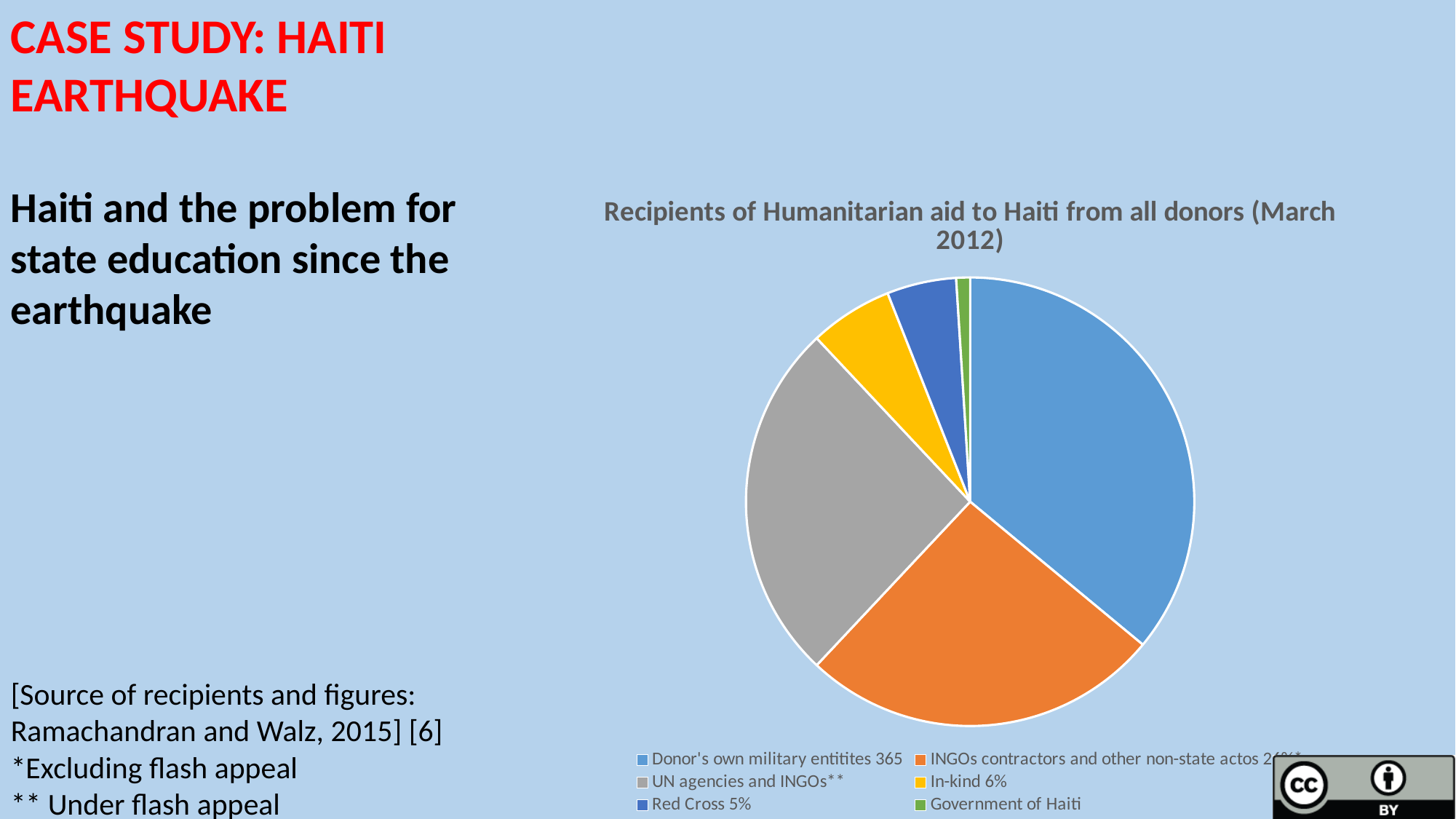
How many slices does the pie chart have? 6 What share of humanitarian aid went to the Red Cross, according to the legend? 5% Which recipient category has the smallest slice of the pie? Government of Haiti What kind of chart is shown on the slide? Pie chart Which slice is larger, Donor's own military entitites or Red Cross? Donor's own military entitites What colour is the slice for Government of Haiti? Green What share of humanitarian aid went to In-kind, according to the legend? 6% Which slice is larger, UN agencies and INGOs or In-kind? UN agencies and INGOs Which recipient category has the largest slice of the pie? Donor's own military entitites What is the title of the chart? Recipients of Humanitarian aid to Haiti from all donors (March 2012) What is the difference in percentage points between the In-kind share and the Red Cross share? 1 Which is larger, the share for In-kind or the share for Red Cross? In-kind